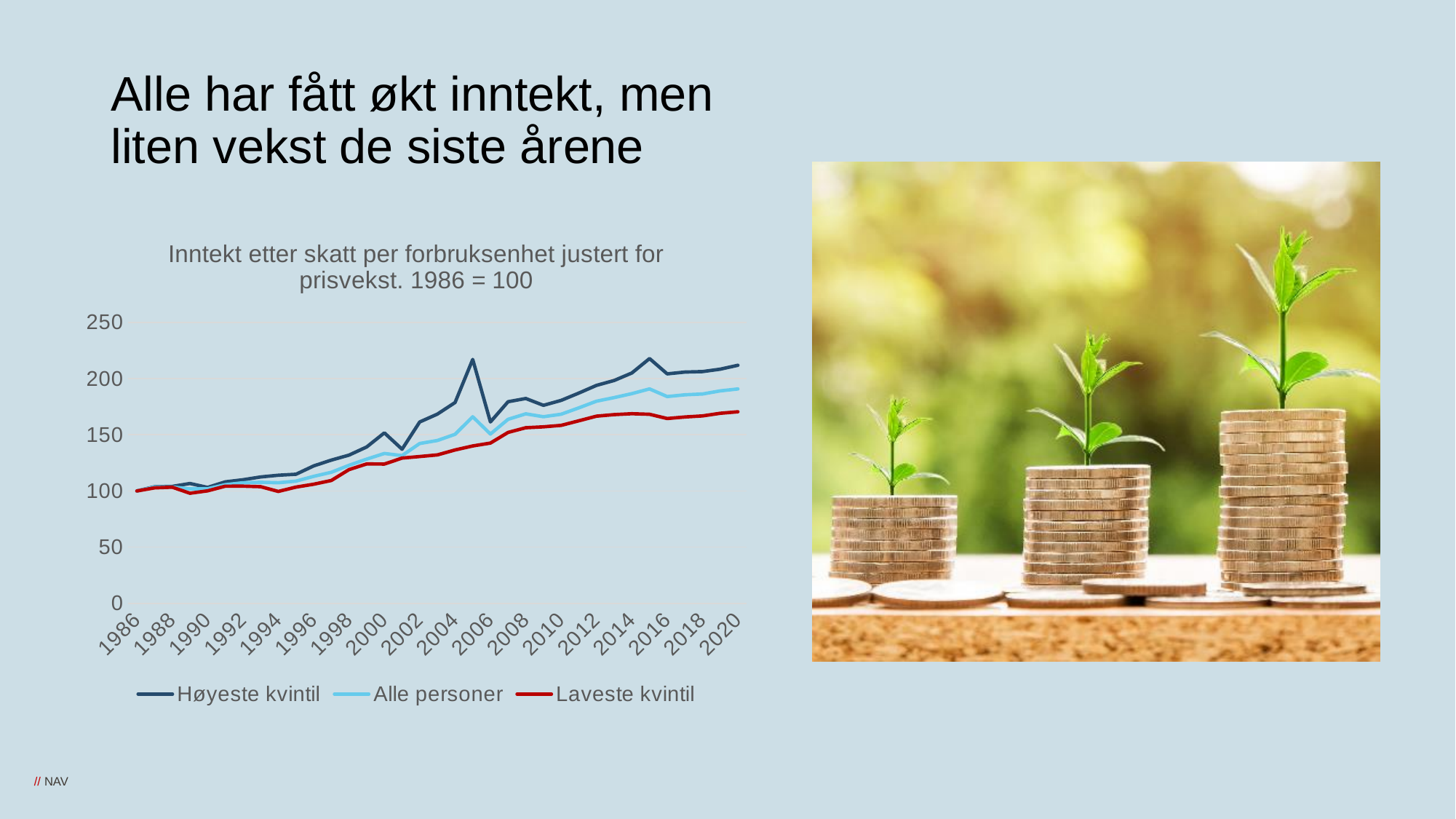
Is the value for Høyeste kvintil in 2020 greater or less than 200? greater What is the title of the chart? Inntekt etter skatt per forbruksenhet justert for prisvekst. 1986 = 100 Which series has the highest value in 2020? Høyeste kvintil Is the value for Laveste kvintil in 2020 greater or less than 200? less Which series is drawn in red? Laveste kvintil Is the value for Alle personer in 2020 greater or less than 150? greater Which is larger in 2010, the value for Høyeste kvintil or the value for Laveste kvintil? Høyeste kvintil What kind of chart is shown on the slide? line chart Which series has the lowest value in 2020? Laveste kvintil How many series does the legend list? 3 Do the values for Alle personer generally rise or fall from 1986 to 2020? rise